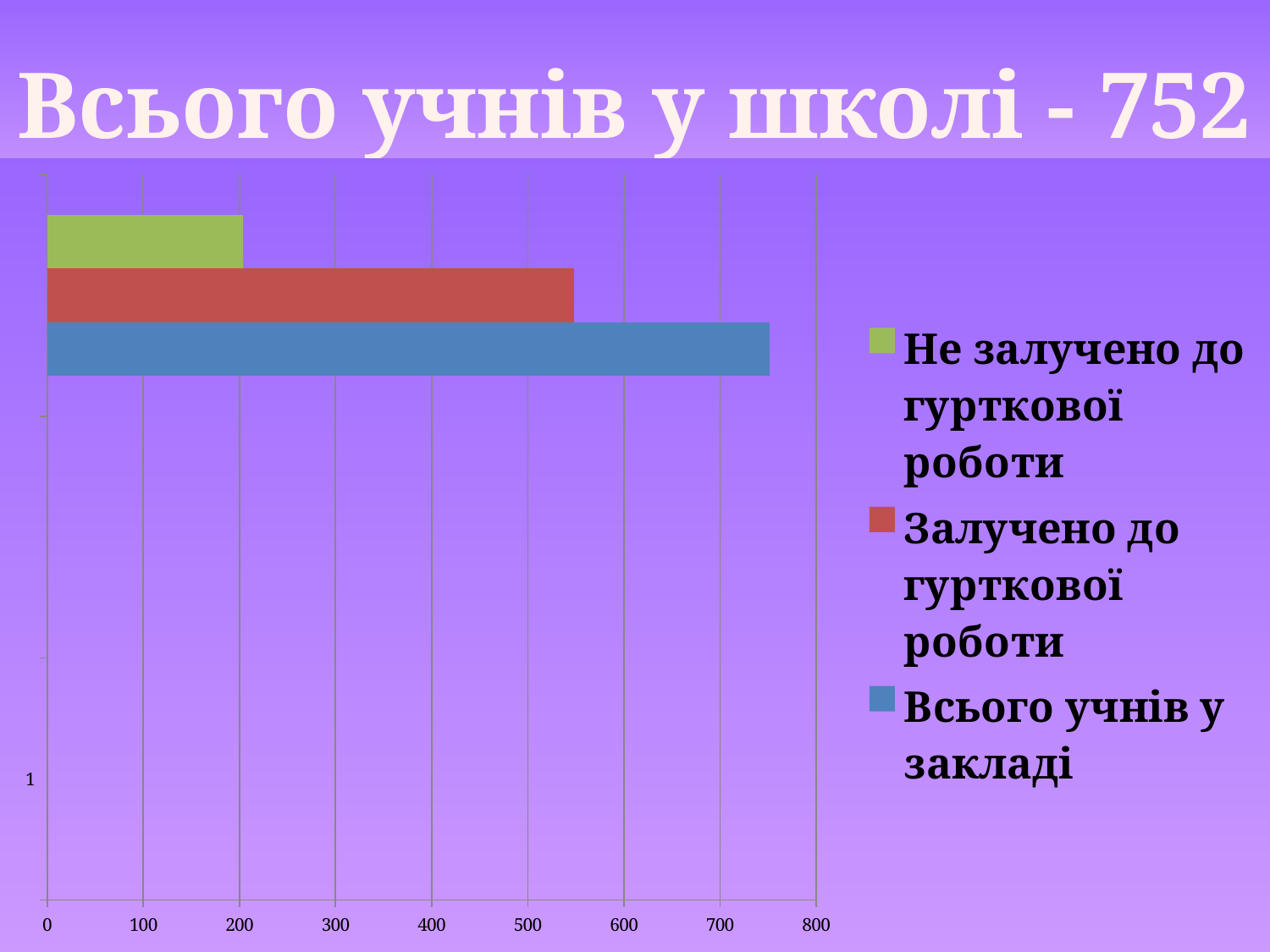
How many series does the legend list? 3 What kind of chart is shown on the slide? bar chart Is the value for 'Не залучено до гурткової роботи' greater or less than 100? greater Which series has the shortest bar? Не залучено до гурткової роботи How many bars are plotted in the chart? 3 Which is larger: the value for 'Залучено до гурткової роботи' or the value for 'Не залучено до гурткової роботи'? Залучено до гурткової роботи Is the value for 'Не залучено до гурткової роботи' greater or less than 300? less What colour is the bar for 'Всього учнів у закладі'? blue Which series has the longest bar? Всього учнів у закладі Is the value for 'Залучено до гурткової роботи' greater or less than 500? greater According to the slide title, how many students are there in the school in total? 752